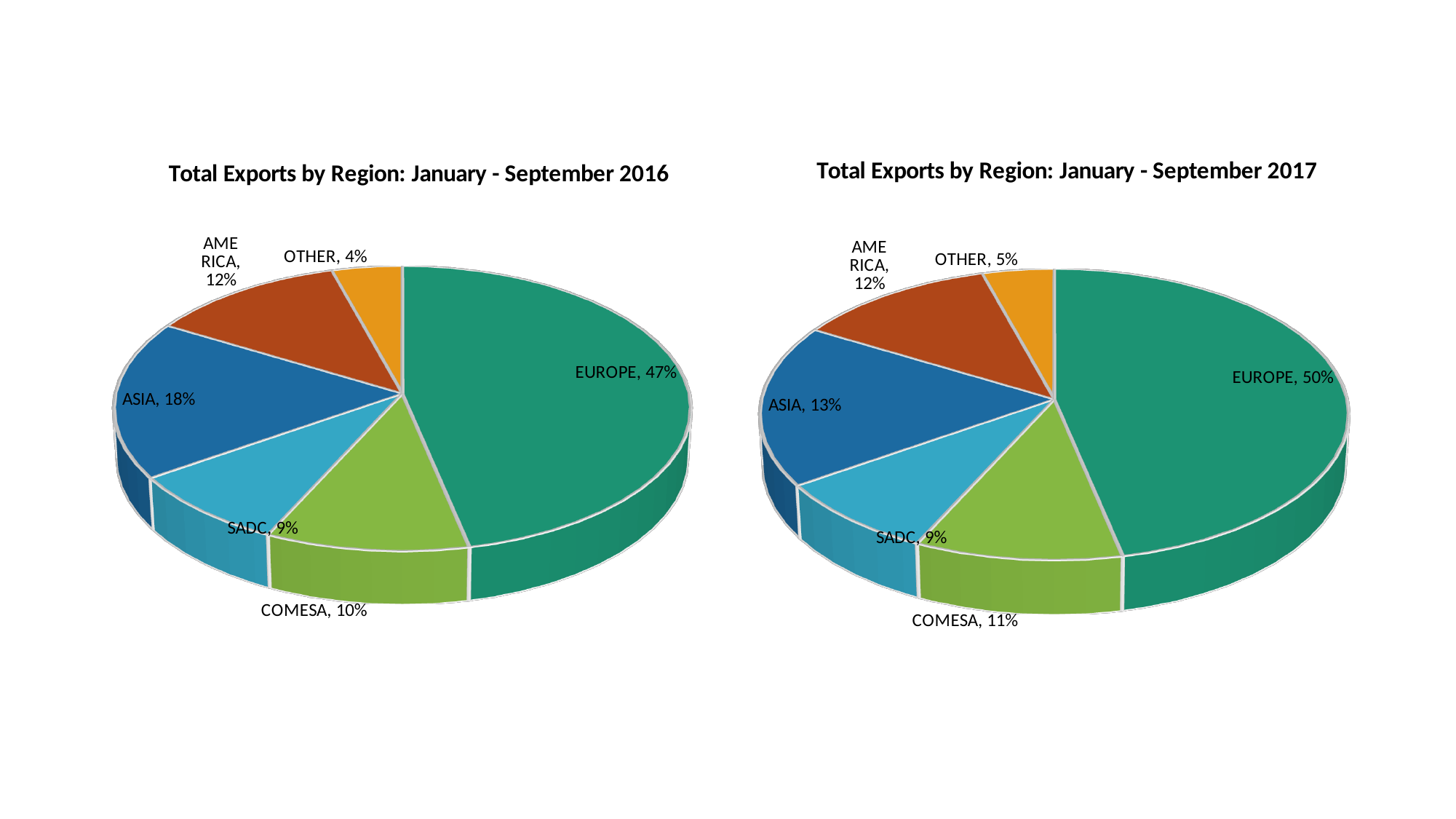
In the 'Total Exports by Region: January - September 2016' chart, which region has the largest share? EUROPE In the 'Total Exports by Region: January - September 2017' chart, which region has the smallest share? OTHER In the 'Total Exports by Region: January - September 2016' chart, what share of exports went to Europe? 47% What colour is the Europe slice in the 'Total Exports by Region: January - September 2017' chart? Green How many regions are shown in the 'Total Exports by Region: January - September 2017' chart? 6 What kind of chart is the 'Total Exports by Region: January - September 2016' chart? Pie chart In the 'Total Exports by Region: January - September 2017' chart, what is the share for OTHER? 5% In the 'Total Exports by Region: January - September 2017' chart, what share of exports went to Asia? 13% In the 'Total Exports by Region: January - September 2017' chart, which is larger, the share for Asia or the share for America? ASIA In the 'Total Exports by Region: January - September 2016' chart, what is the difference between the Asia share and the America share? 6% By how much did Europe's share change from the 2016 chart to the 2017 chart? 3% In the 'Total Exports by Region: January - September 2016' chart, what is the share for COMESA? 10%